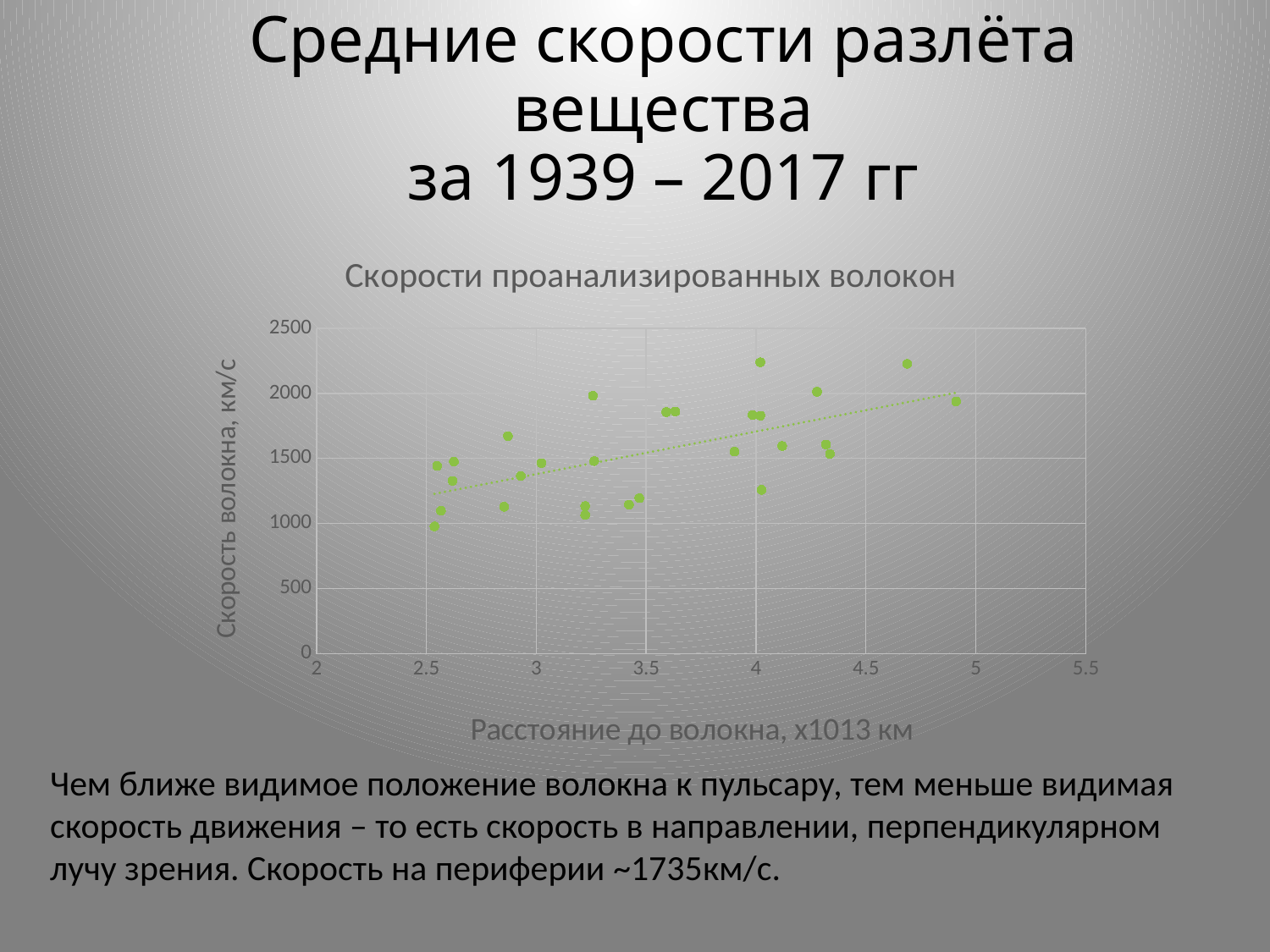
What is the title of the chart? Скорости проанализированных волокон What is the maximum value shown on the horizontal axis of the chart? 5.5 Is the highest plotted fibre speed greater or less than 2000 km/s? greater Is the speed of the point plotted at a distance of about 4.7 greater or less than 2000? greater Is the lowest plotted fibre speed greater or less than 1500 km/s? less Which has the higher plotted speed: the point at a distance of about 4.7 or the point at a distance of about 4.9? the point at about 4.7 Do the plotted fibre speeds generally rise or fall as the distance to the fibre increases along the x axis? rise What is the maximum value shown on the vertical axis of the chart? 2500 What kind of chart is shown on the slide? scatter chart What is the label of the vertical axis of the chart? Скорость волокна, км/с